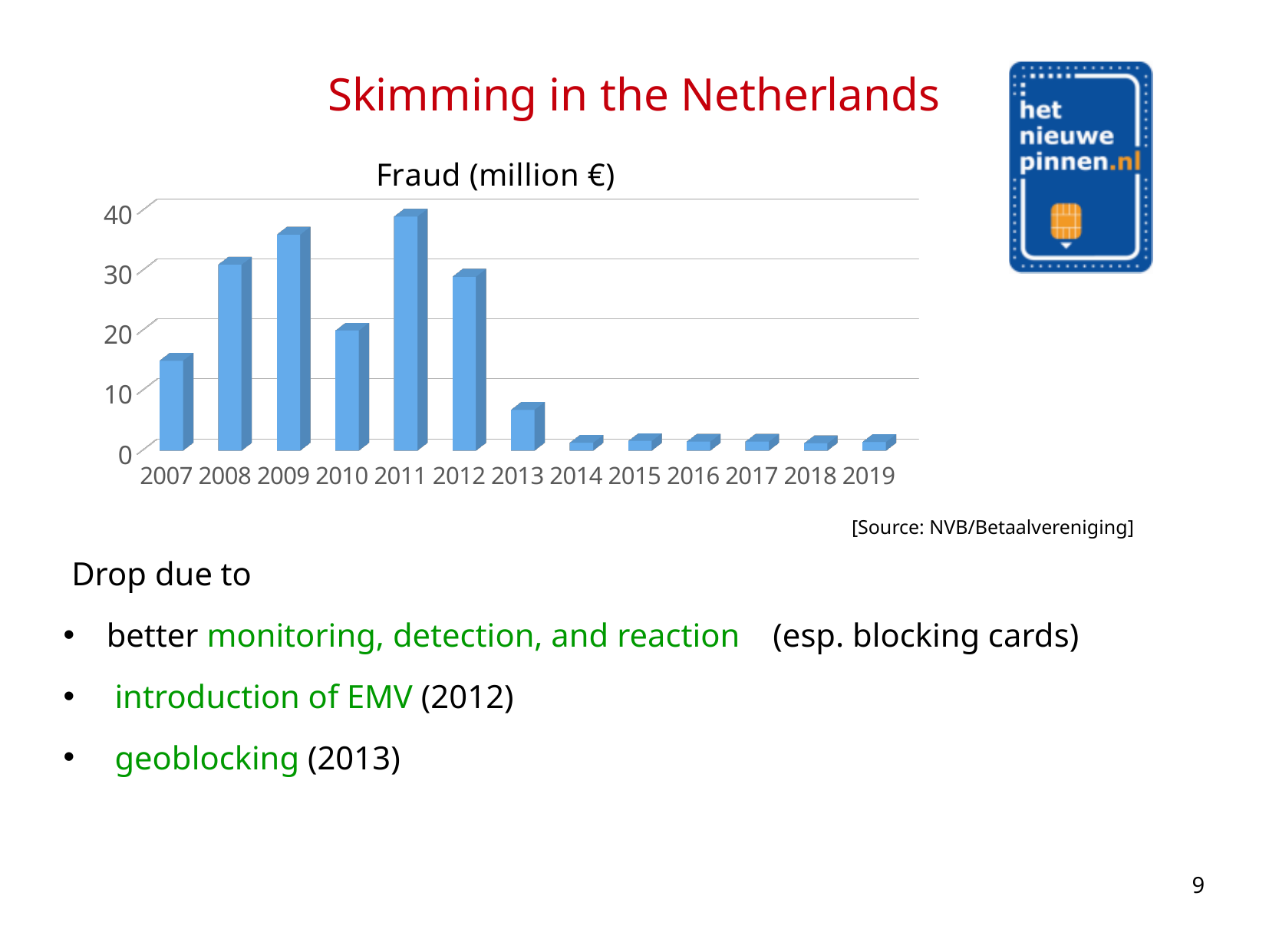
Is the fraud value for 2009 greater or less than 30? greater Is the fraud value for 2014 greater or less than 10? less What is the title of the chart? Fraud (million €) Which year has the larger fraud value, 2009 or 2010? 2009 Do the fraud values rise or fall from 2011 to 2019? fall What kind of chart is shown on the slide? bar chart Which year has the larger fraud value, 2011 or 2012? 2011 Is the fraud value for 2007 greater or less than 10? greater How many years are shown on the x axis of the chart? 13 Which year has the highest fraud value in the chart? 2011